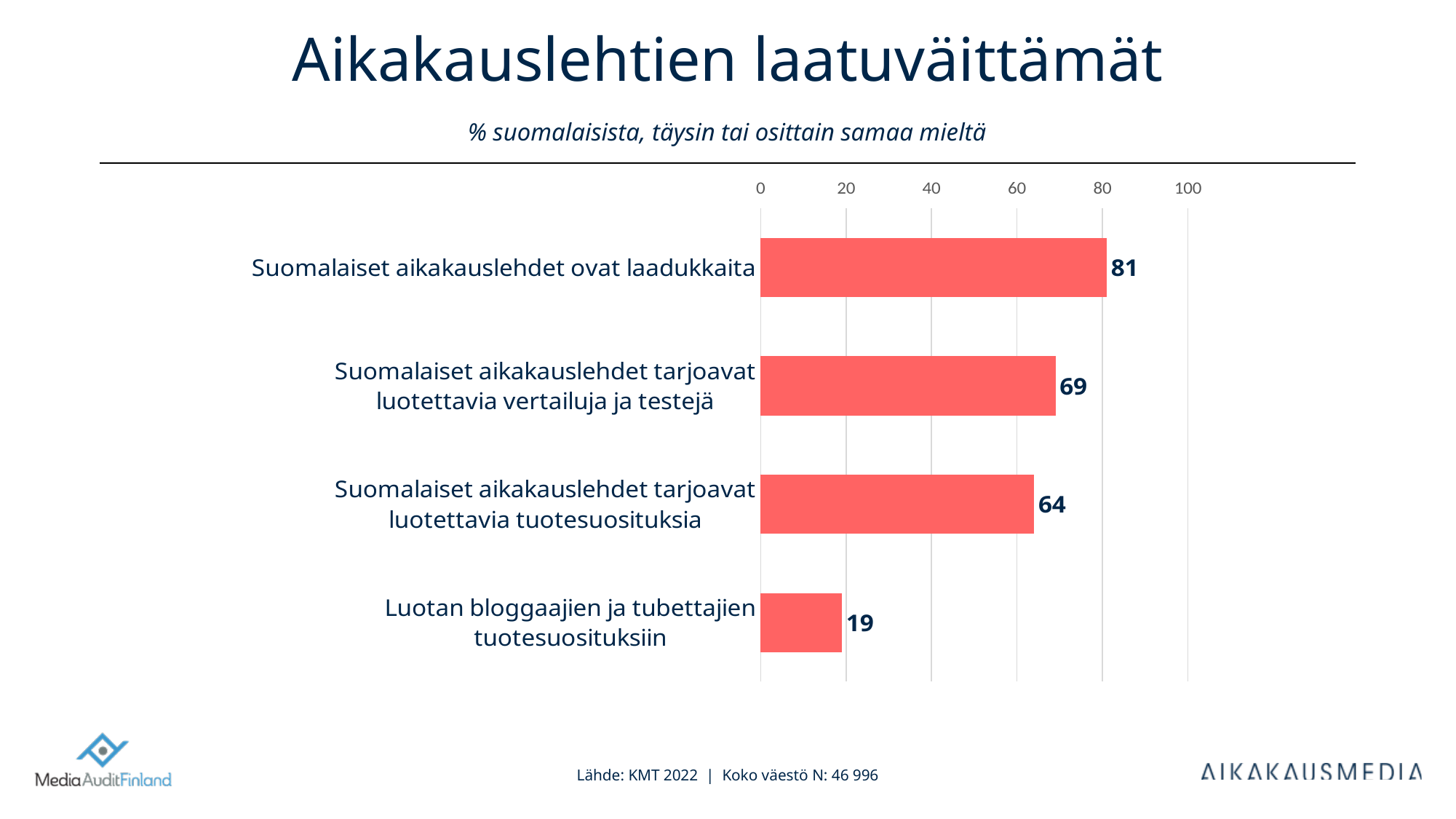
What is the difference between the values for "Suomalaiset aikakauslehdet tarjoavat luotettavia vertailuja ja testejä" and "Suomalaiset aikakauslehdet tarjoavat luotettavia tuotesuosituksia"? 5 What is the title of the chart? Aikakauslehtien laatuväittämät What is the value for "Suomalaiset aikakauslehdet ovat laadukkaita"? 81 What is the difference between the values for "Suomalaiset aikakauslehdet ovat laadukkaita" and "Luotan bloggaajien ja tubettajien tuotesuosituksiin"? 62 Which category has the highest value? Suomalaiset aikakauslehdet ovat laadukkaita What is the value for "Suomalaiset aikakauslehdet tarjoavat luotettavia tuotesuosituksia"? 64 What is the value for "Luotan bloggaajien ja tubettajien tuotesuosituksiin"? 19 Which category has the lowest value? Luotan bloggaajien ja tubettajien tuotesuosituksiin What is the value for "Suomalaiset aikakauslehdet tarjoavat luotettavia vertailuja ja testejä"? 69 Which is larger: the value for "Suomalaiset aikakauslehdet tarjoavat luotettavia vertailuja ja testejä" or for "Suomalaiset aikakauslehdet tarjoavat luotettavia tuotesuosituksia"? Suomalaiset aikakauslehdet tarjoavat luotettavia vertailuja ja testejä How many categories are shown in the chart? 4 What kind of chart is shown on the slide? Bar chart